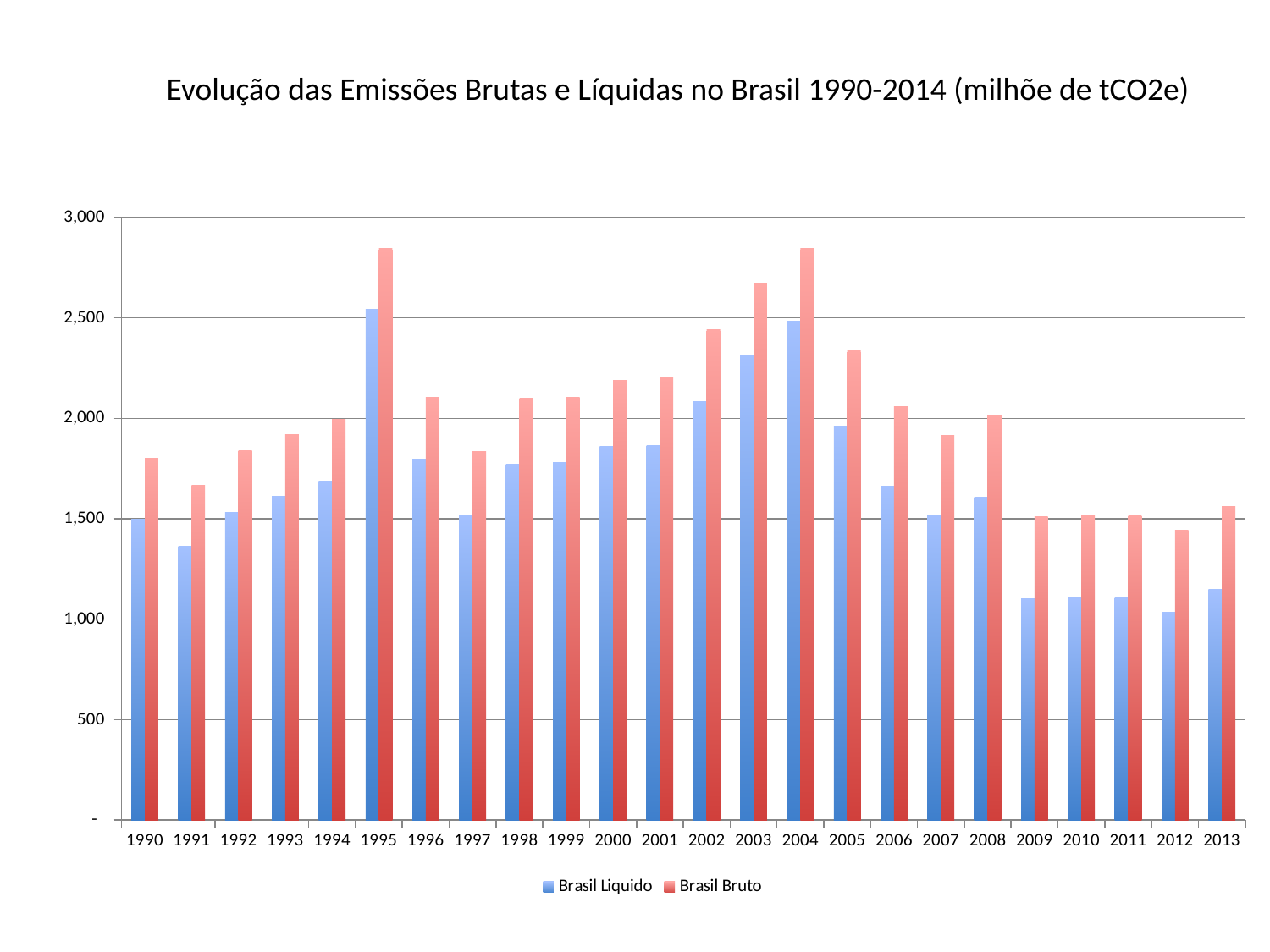
How many series does the legend list? 2 How many years are shown on the x axis? 24 What kind of chart is shown on the slide? bar chart Which is larger, the Brasil Bruto value for 2003 or for 2005? 2003 Is the Brasil Liquido value for 2009 greater or less than 1,000? greater Which year has the lowest Brasil Bruto value? 2012 Is the Brasil Bruto value for 1995 greater or less than 2,500? greater Is the Brasil Liquido value for 1991 greater or less than 1,500? less What is the title of the chart? Evolução das Emissões Brutas e Líquidas no Brasil 1990-2014 (milhõe de tCO2e) Which series is shown in red? Brasil Bruto Do the Brasil Liquido values rise or fall from 2004 to 2009? fall